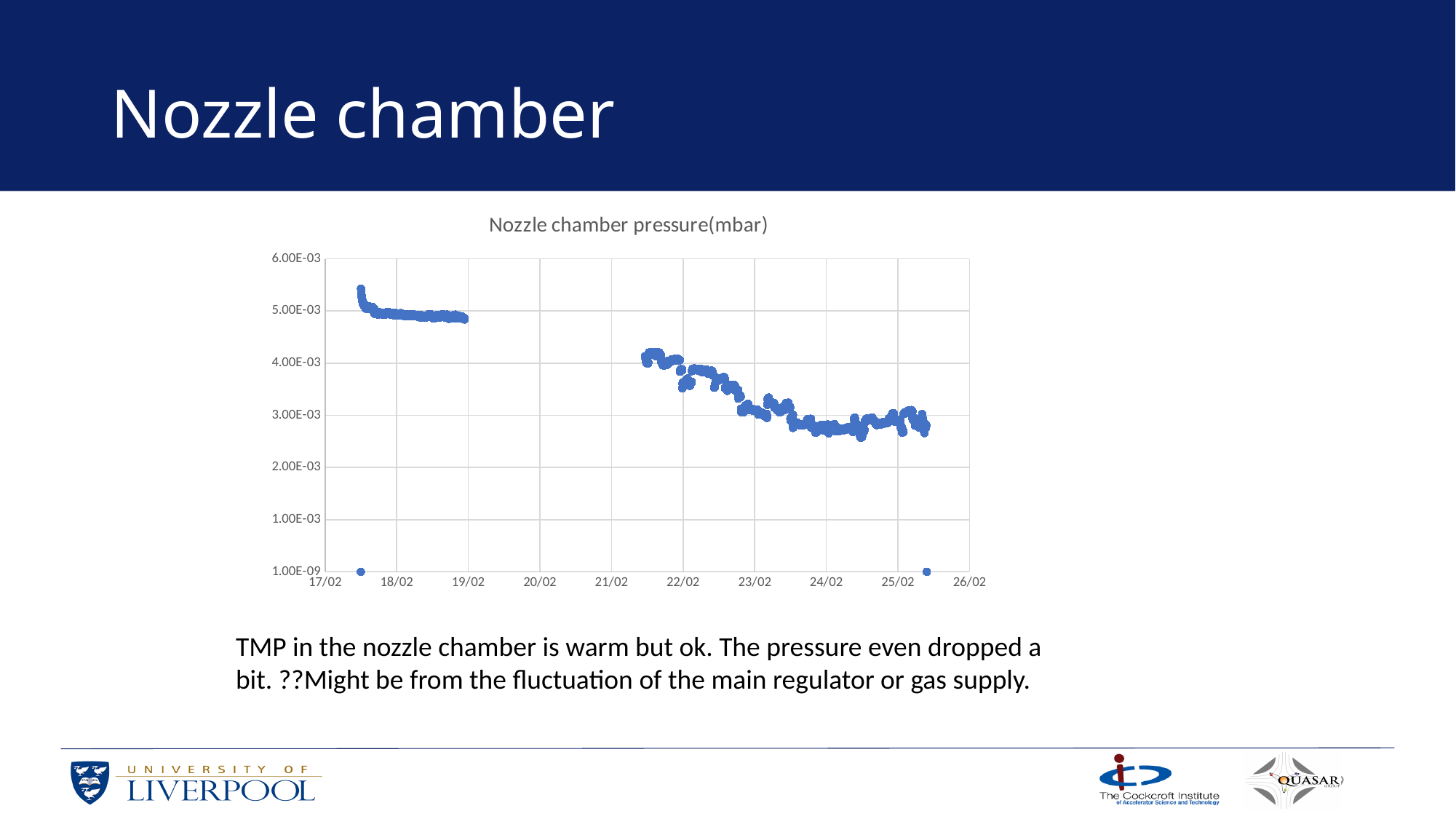
What is the last date label on the x axis? 26/02 What is the first date label on the x axis? 17/02 Is the pressure around 22/02 greater or less than 3.00E-03? greater Is the pressure around 18/02 greater or less than 6.00E-03? less What is the title of the chart? Nozzle chamber pressure(mbar) Which is higher, the pressure around 18/02 or the pressure around 24/02? 18/02 Do the pressure values generally rise or fall from 17/02 to 26/02? fall What kind of chart is shown on the slide? scatter chart Is the pressure around 18/02 greater or less than 4.00E-03? greater What is the highest value shown on the y axis? 6.00E-03 How many date labels are shown on the x axis? 10